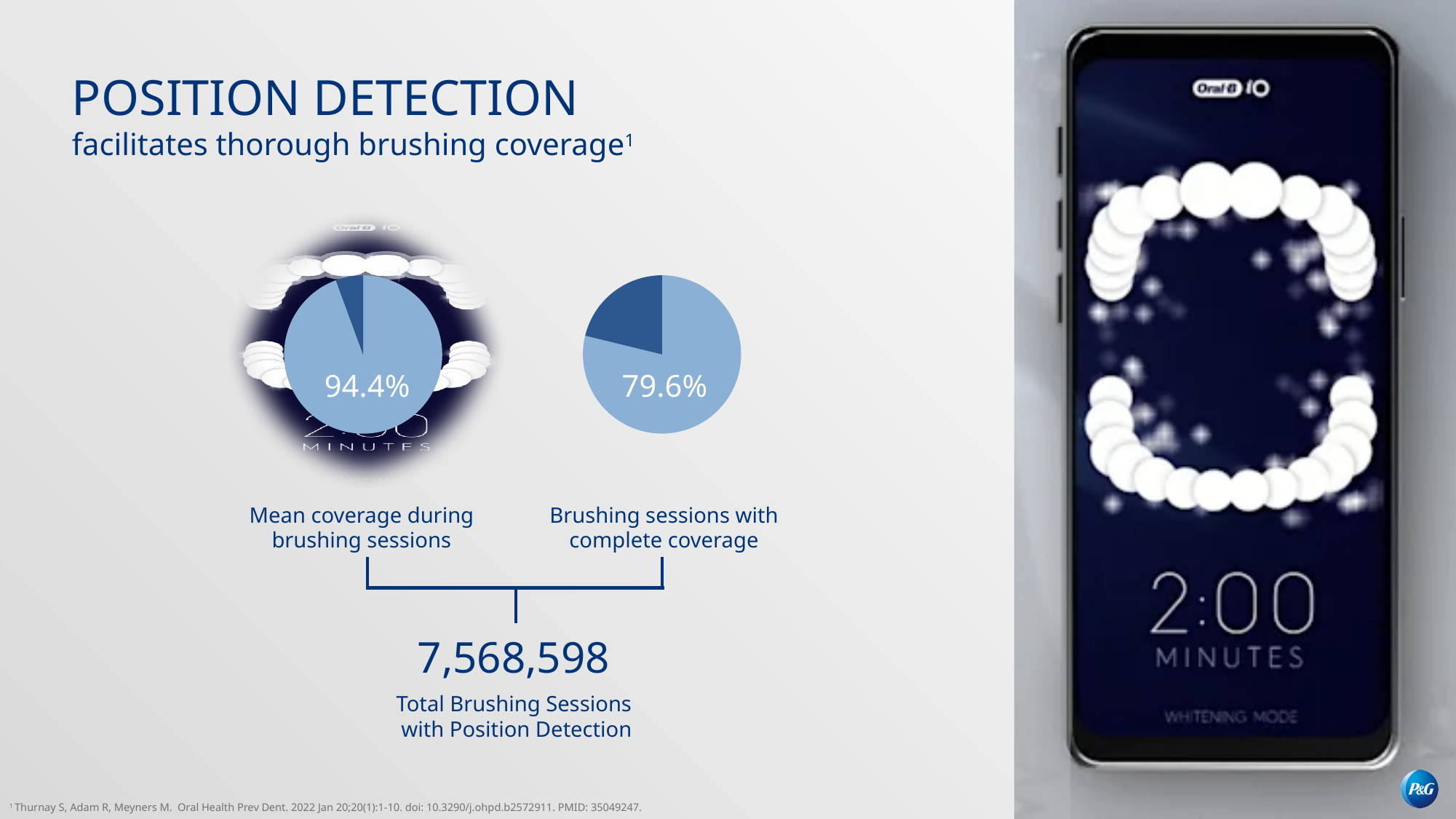
How many pie charts are shown on the slide? 2 What is the label under the left pie chart? Mean coverage during brushing sessions What is the total number of brushing sessions with position detection shown below the pie charts? 7,568,598 Which is larger: the mean coverage during brushing sessions (left pie) or the share of brushing sessions with complete coverage (right pie)? Mean coverage during brushing sessions What is the difference in percentage points between the value in the left pie chart (94.4%) and the value in the right pie chart (79.6%)? 14.8 How many slices does the right pie chart (brushing sessions with complete coverage) have? 2 What kind of chart is used to show the mean coverage during brushing sessions? pie chart In the right pie chart, what percentage of brushing sessions had complete coverage? 79.6% In the left pie chart, what is the mean coverage during brushing sessions? 94.4% Is the value shown in the right pie chart greater or less than 80%? less What colour is the large slice in both pie charts? light blue